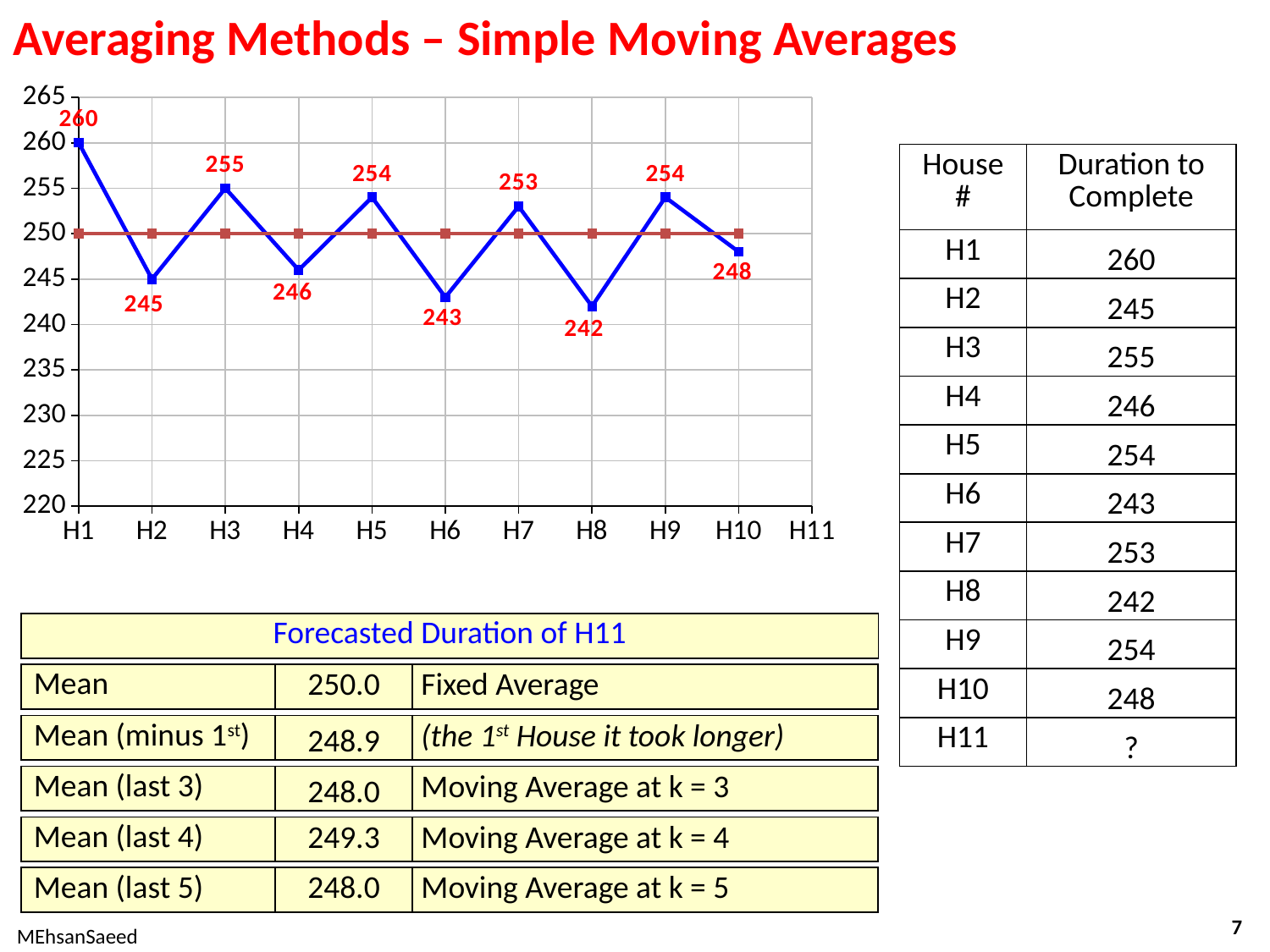
What is the value plotted for H10 on the blue line? 248 Which category has the highest value on the blue line? H1 Which is larger on the blue line, the value for H5 or the value for H6? H5 Which category has the lowest value on the blue line? H8 What is the difference between the values for H3 and H4 on the blue line? 9 How many data points are plotted on the blue line? 10 What is the value plotted for H1 on the blue line? 260 What is the value plotted for H8 on the blue line? 242 What is the difference between the values for H1 and H2 on the blue line? 15 What type of chart is shown on the slide? line chart Is the value for H7 on the blue line greater or less than 250? greater At what value does the flat red line sit on the y axis? 250